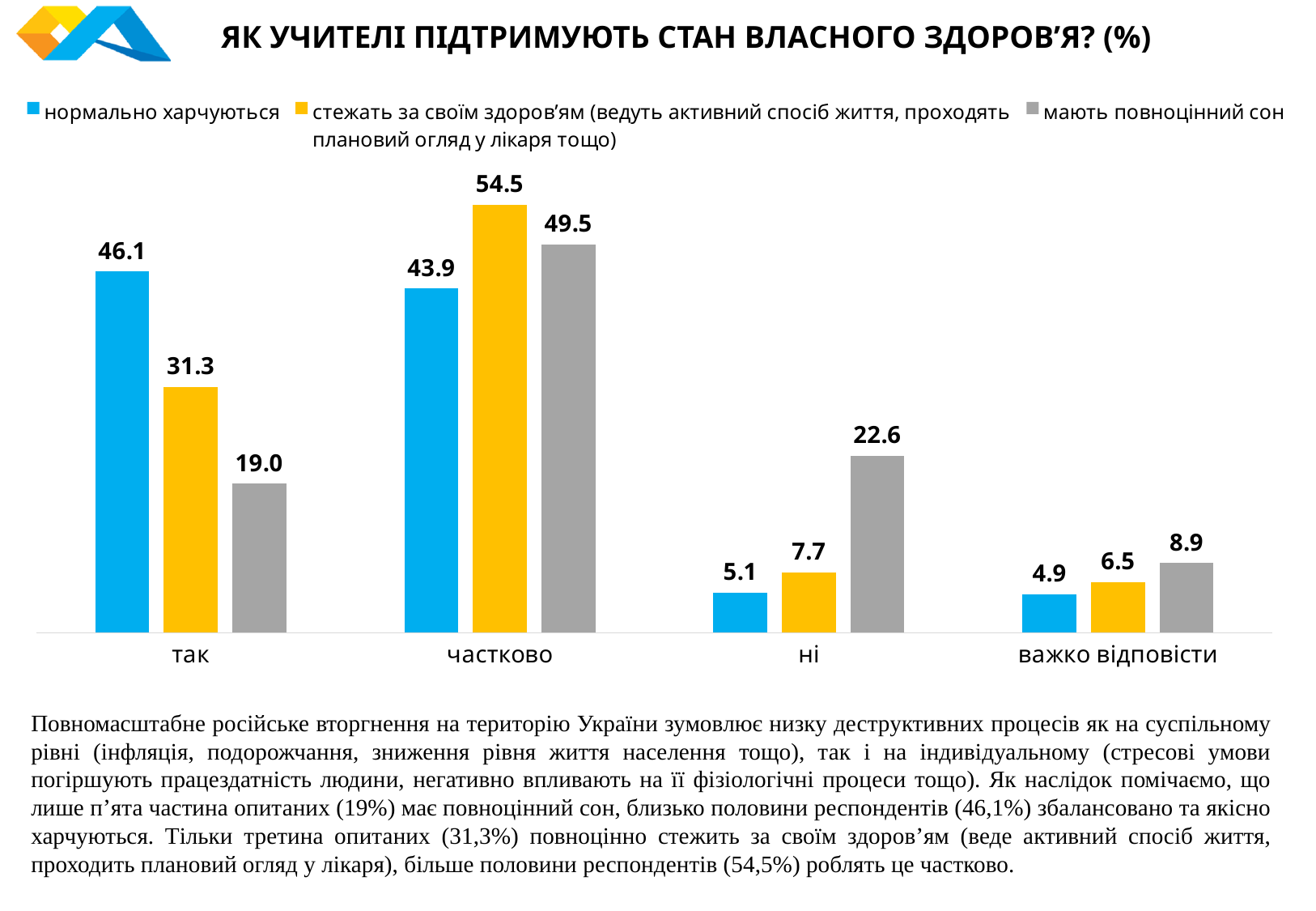
What is the difference between 'нормально харчуються' and 'мають повноцінний сон' in the 'так' category? 27.1 What is the difference between 'стежать за своїм здоров’ям' in 'частково' and in 'так'? 23.2 What colour are the bars for 'мають повноцінний сон'? grey How many series does the legend list? 3 What is the value for 'мають повноцінний сон' in the 'частково' category? 49.5 What is the value for 'нормально харчуються' in the 'так' category? 46.1 What kind of chart is shown on the slide? bar chart What is the value for 'стежать за своїм здоров’ям' in the 'ні' category? 7.7 Which category has the highest value for 'стежать за своїм здоров’ям'? частково How many categories are shown on the x axis? 4 In the 'ні' category, which is larger: 'нормально харчуються' or 'мають повноцінний сон'? мають повноцінний сон Which category has the lowest value for 'нормально харчуються'? важко відповісти